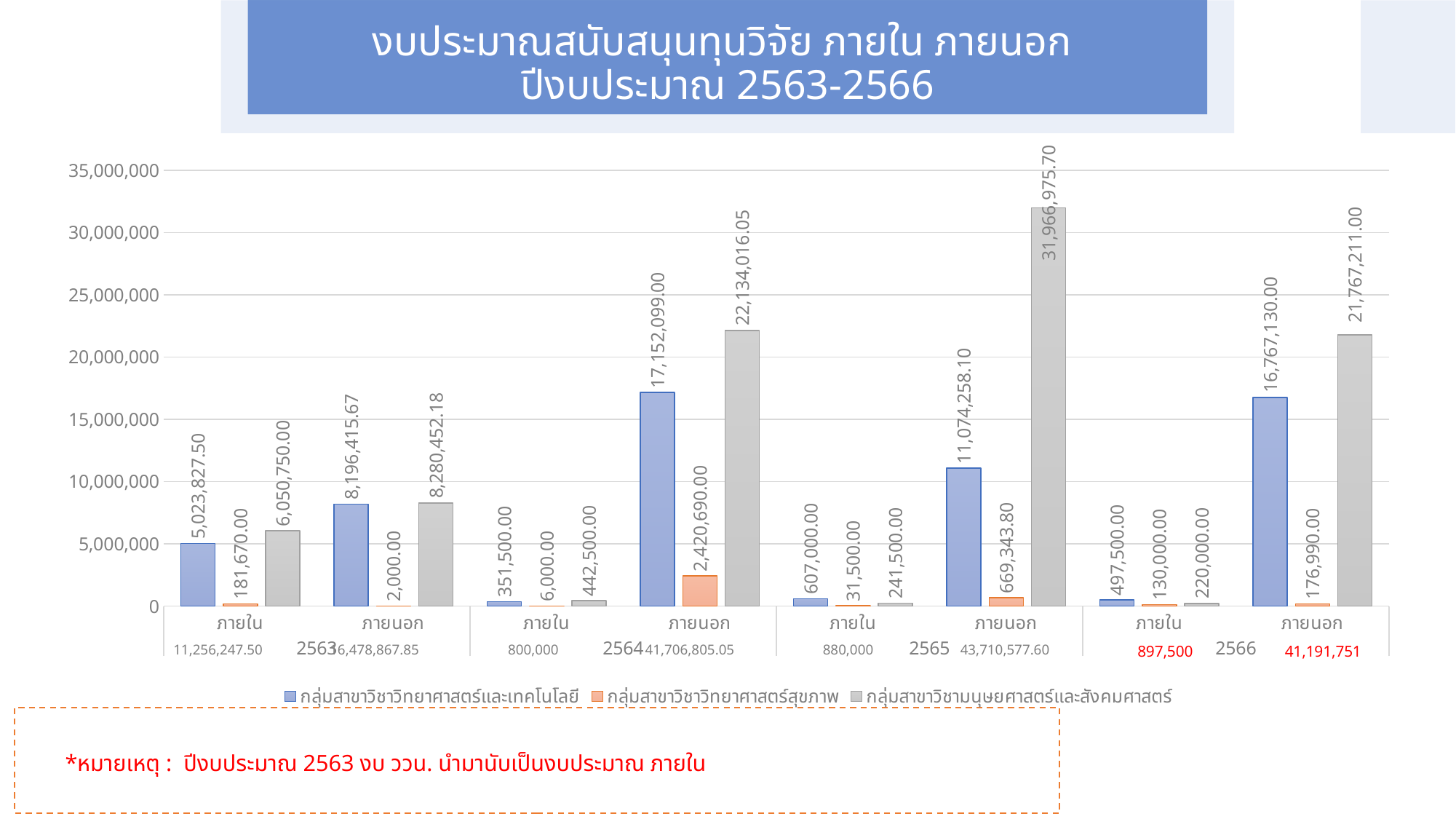
What is the value for กลุ่มสาขาวิชาวิทยาศาสตร์และเทคโนโลยี in ภายนอก for 2564? 17,152,099.00 Is the value for กลุ่มสาขาวิชามนุษยศาสตร์และสังคมศาสตร์ in ภายนอก for 2564 greater or less than 20,000,000? greater Which is larger in ภายใน for 2565: กลุ่มสาขาวิชาวิทยาศาสตร์และเทคโนโลยี or กลุ่มสาขาวิชามนุษยศาสตร์และสังคมศาสตร์? กลุ่มสาขาวิชาวิทยาศาสตร์และเทคโนโลยี How many category groups (ภายใน/ภายนอก across all years) are shown on the x axis? 8 Which bar has the highest value in the whole chart? กลุ่มสาขาวิชามนุษยศาสตร์และสังคมศาสตร์, ภายนอก 2565 What is the value for กลุ่มสาขาวิชาวิทยาศาสตร์และเทคโนโลยี in ภายใน for 2566? 497,500.00 What type of chart is shown on the slide? bar chart What is the value for กลุ่มสาขาวิชามนุษยศาสตร์และสังคมศาสตร์ in ภายนอก for 2565? 31,966,975.70 How many series does the legend list? 3 What is the difference between กลุ่มสาขาวิชามนุษยศาสตร์และสังคมศาสตร์ and กลุ่มสาขาวิชาวิทยาศาสตร์และเทคโนโลยี in ภายนอก for 2566? 5,000,081.00 What is the value for กลุ่มสาขาวิชาวิทยาศาสตร์สุขภาพ in ภายใน for 2563? 181,670.00 Which series has the lowest value in ภายนอก for 2563? กลุ่มสาขาวิชาวิทยาศาสตร์สุขภาพ